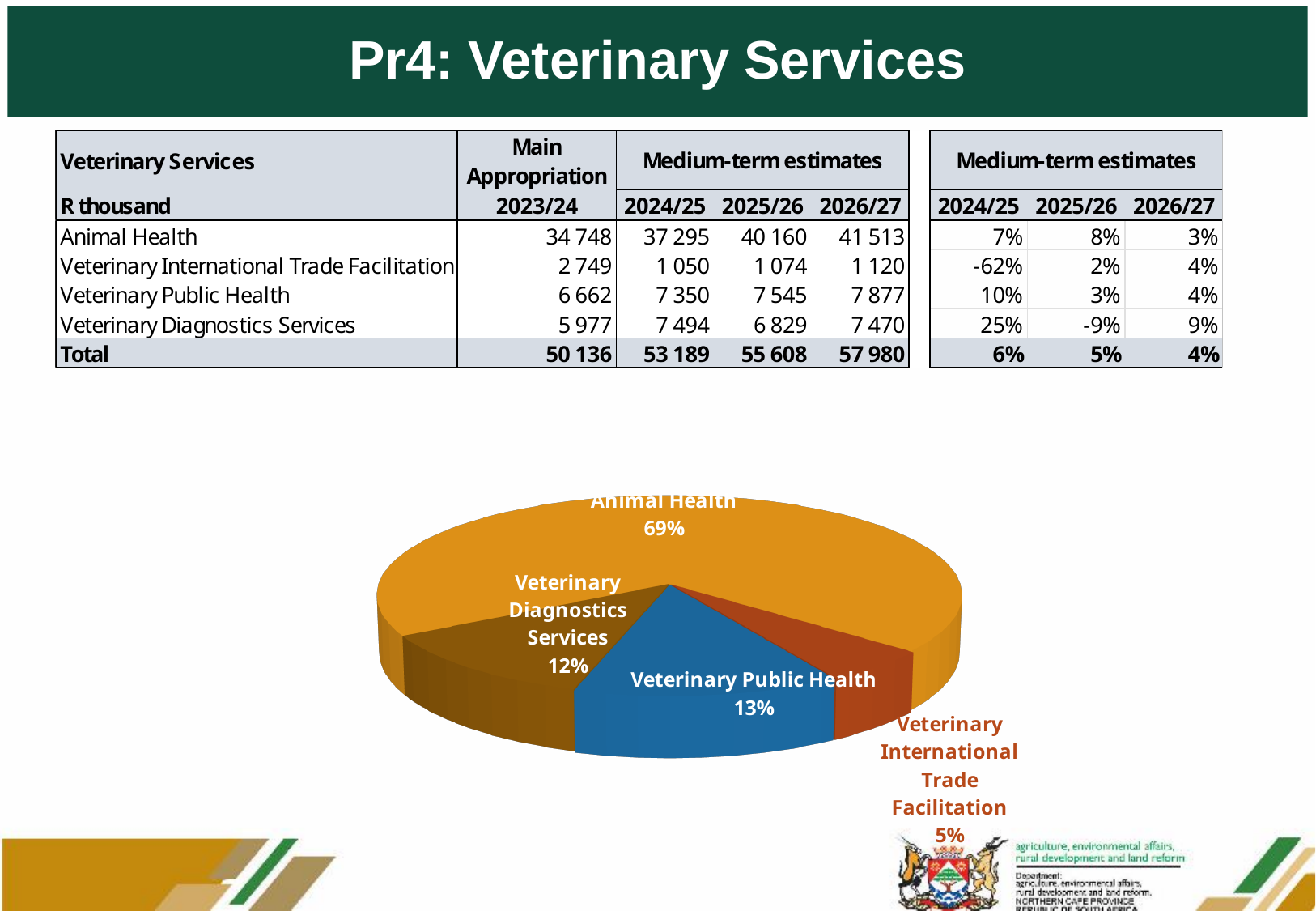
In the pie chart, what is the difference in percentage points between Animal Health and Veterinary Public Health? 56 What share of the pie chart is Veterinary Public Health? 13% How many slices does the pie chart have? 4 What share of the pie chart is Veterinary International Trade Facilitation? 5% What kind of chart is shown on the slide? pie chart In the pie chart, what is the difference in percentage points between Veterinary Diagnostics Services and Veterinary International Trade Facilitation? 7 In the pie chart, which is larger: Veterinary Public Health or Veterinary Diagnostics Services? Veterinary Public Health What colour is the Veterinary Public Health slice in the pie chart? blue What share of the pie chart is Veterinary Diagnostics Services? 12% Which slice of the pie chart is the largest? Animal Health Which slice of the pie chart is the smallest? Veterinary International Trade Facilitation